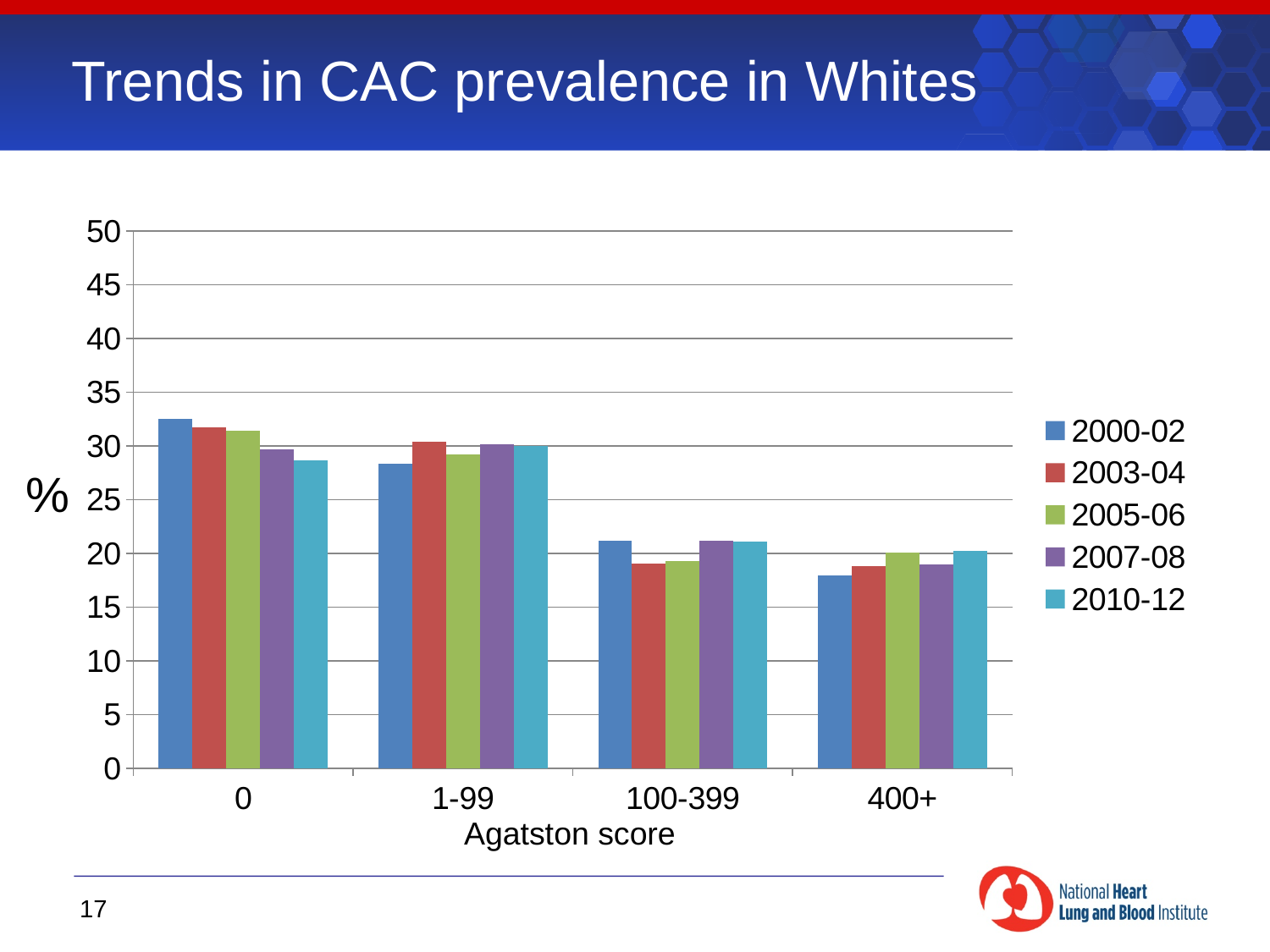
Do the 2000-02 values rise or fall as you move from the 0 category to the 400+ category along the x axis? fall Within the Agatston score 0 category, do the bars rise or fall from 2000-02 to 2010-12? fall Which Agatston score category has the lowest 2000-02 bar? 400+ Is the value for 2000-02 in the 400+ category greater or less than 20? less Which Agatston score category has the highest 2000-02 bar? 0 In the 100-399 category, which is larger: the 2000-02 bar or the 2003-04 bar? 2000-02 What is the title of the x axis? Agatston score How many Agatston score categories are shown on the x axis? 4 What kind of chart is shown on the slide? bar chart How many series does the legend list? 5 Is the value for 2000-02 in the Agatston score 0 category greater or less than 30? greater Is the value for 2010-12 in the Agatston score 0 category greater or less than 30? less